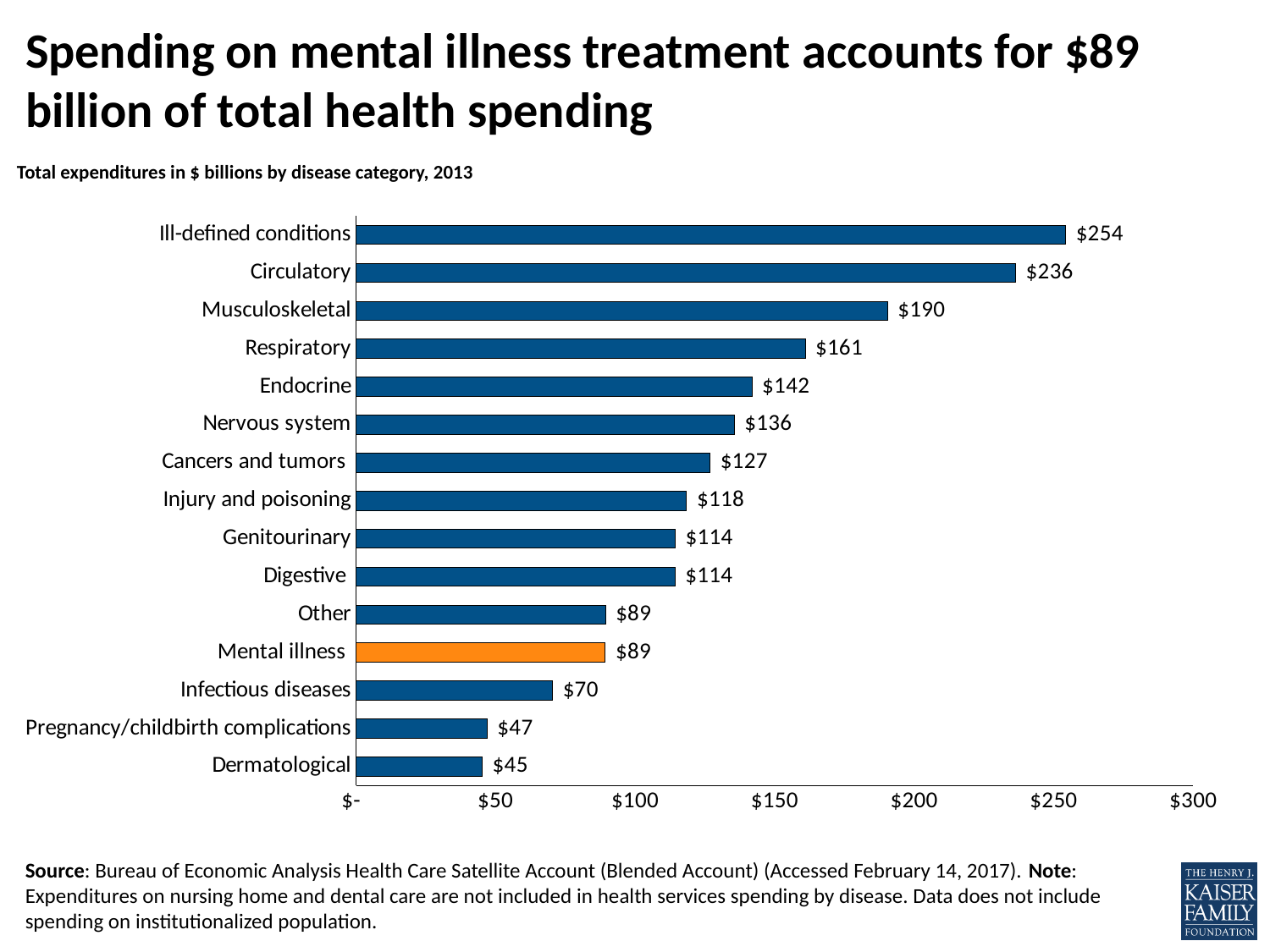
What is the value for Respiratory? $161 How many disease categories are shown in the chart? 15 Is the value for Musculoskeletal greater or less than $150? greater Which bar is highlighted in orange? Mental illness What is the difference between the values for Ill-defined conditions and Circulatory? $18 What is the value for Dermatological? $45 Which disease category has the lowest expenditure? Dermatological What kind of chart is shown on the slide? Bar chart Which is larger, the value for Endocrine or the value for Nervous system? Endocrine Which disease category has the highest expenditure? Ill-defined conditions What is the value for Mental illness? $89 What is the difference between the values for Mental illness and Infectious diseases? $19